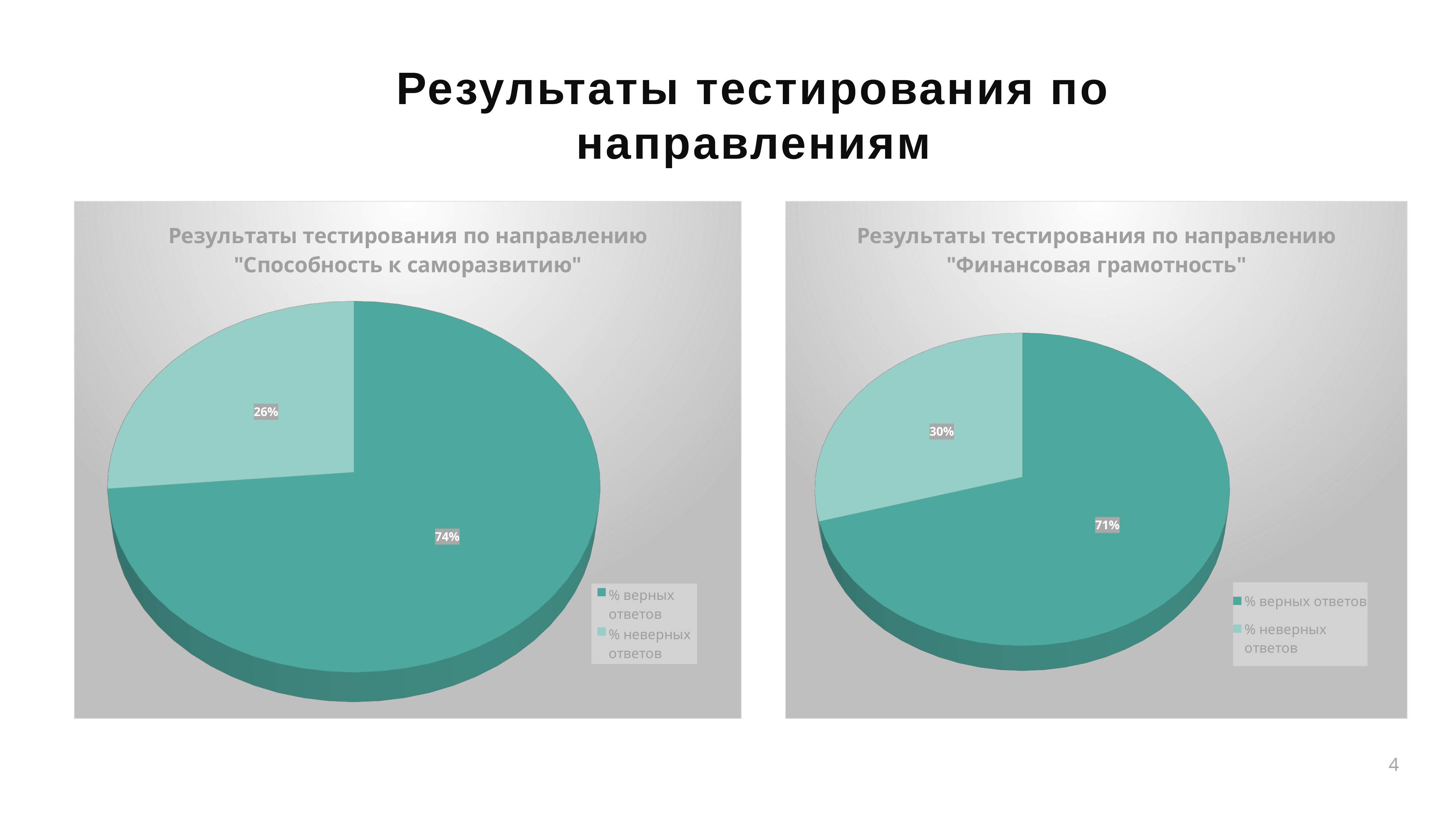
In the left chart ("Способность к саморазвитию"), what is the difference between the "% верных ответов" and "% неверных ответов" slices? 48% In the right chart ("Финансовая грамотность"), what percentage is shown for "% верных ответов"? 71% Which chart shows a higher value for "% верных ответов": the left chart ("Способность к саморазвитию") or the right chart ("Финансовая грамотность")? The left chart ("Способность к саморазвитию") How many entries does the legend of the left chart ("Способность к саморазвитию") list? 2 What type of chart is the left chart ("Способность к саморазвитию")? Pie chart How many slices does the right chart ("Финансовая грамотность") have? 2 In the right chart ("Финансовая грамотность"), what percentage is shown for "% неверных ответов"? 30% In the left chart ("Способность к саморазвитию"), which slice is the largest? % верных ответов In the right chart ("Финансовая грамотность"), what is the difference between the "% верных ответов" and "% неверных ответов" slices? 41% In the left chart ("Способность к саморазвитию"), what percentage is shown for "% верных ответов"? 74% In the left chart ("Способность к саморазвитию"), what percentage is shown for "% неверных ответов"? 26% In the right chart ("Финансовая грамотность"), which slice is the smallest? % неверных ответов